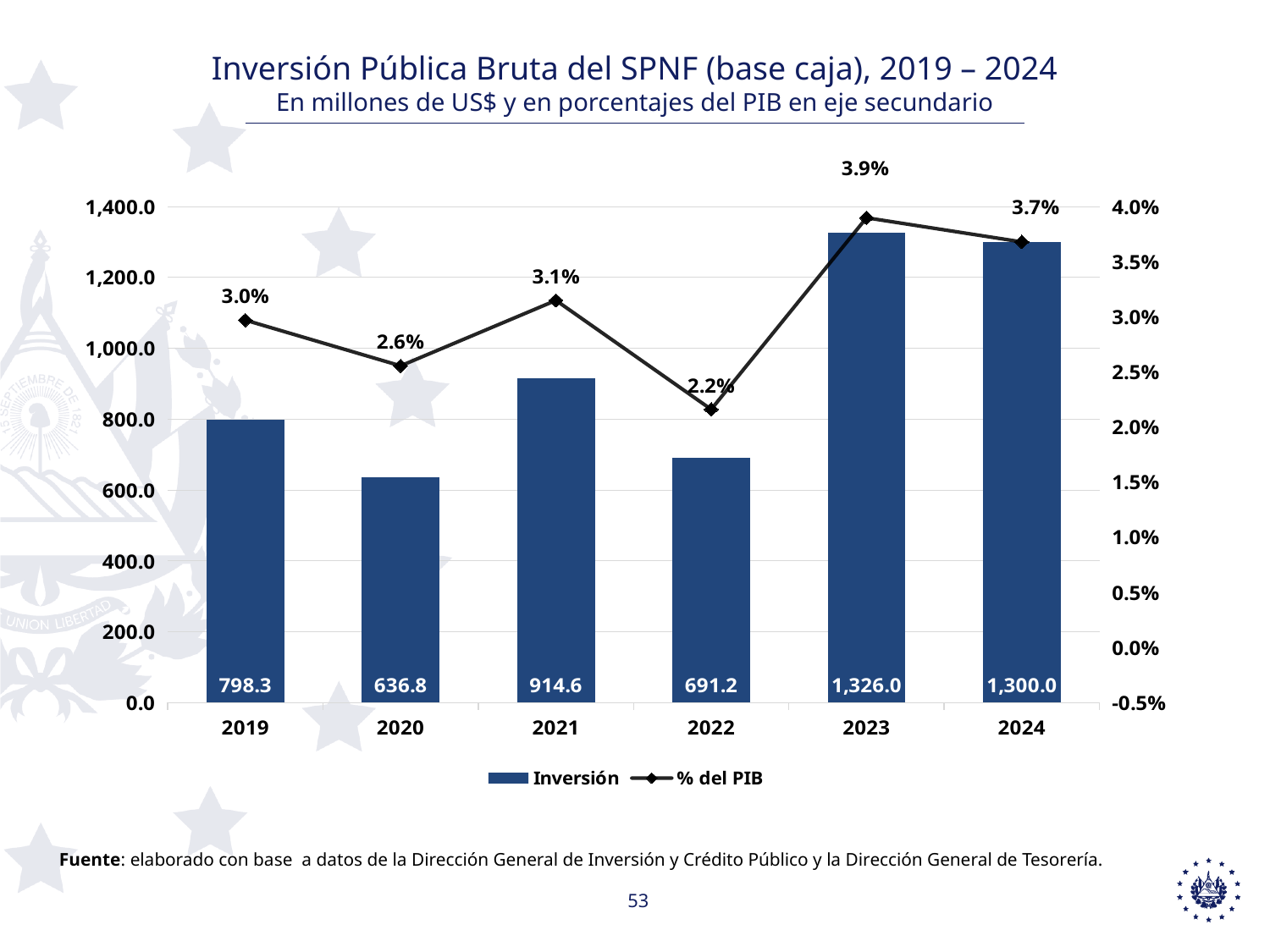
What is the difference between the Inversión values for 2023 and 2024? 26.0 How many series does the legend list? 2 Which year has the highest Inversión value? 2023 What is the title of the chart? Inversión Pública Bruta del SPNF (base caja), 2019 – 2024 Does the % del PIB value rise or fall from 2022 to 2023? rise What is the Inversión value for 2021? 914.6 Which year has the lowest % del PIB value? 2022 How many years are shown on the x axis? 6 Which is larger, the Inversión value for 2019 or for 2022? 2019 What is the % del PIB value for 2022? 2.2% Is the Inversión value for 2020 greater or less than 800.0? less What kind of chart is used for the Inversión series? bar chart